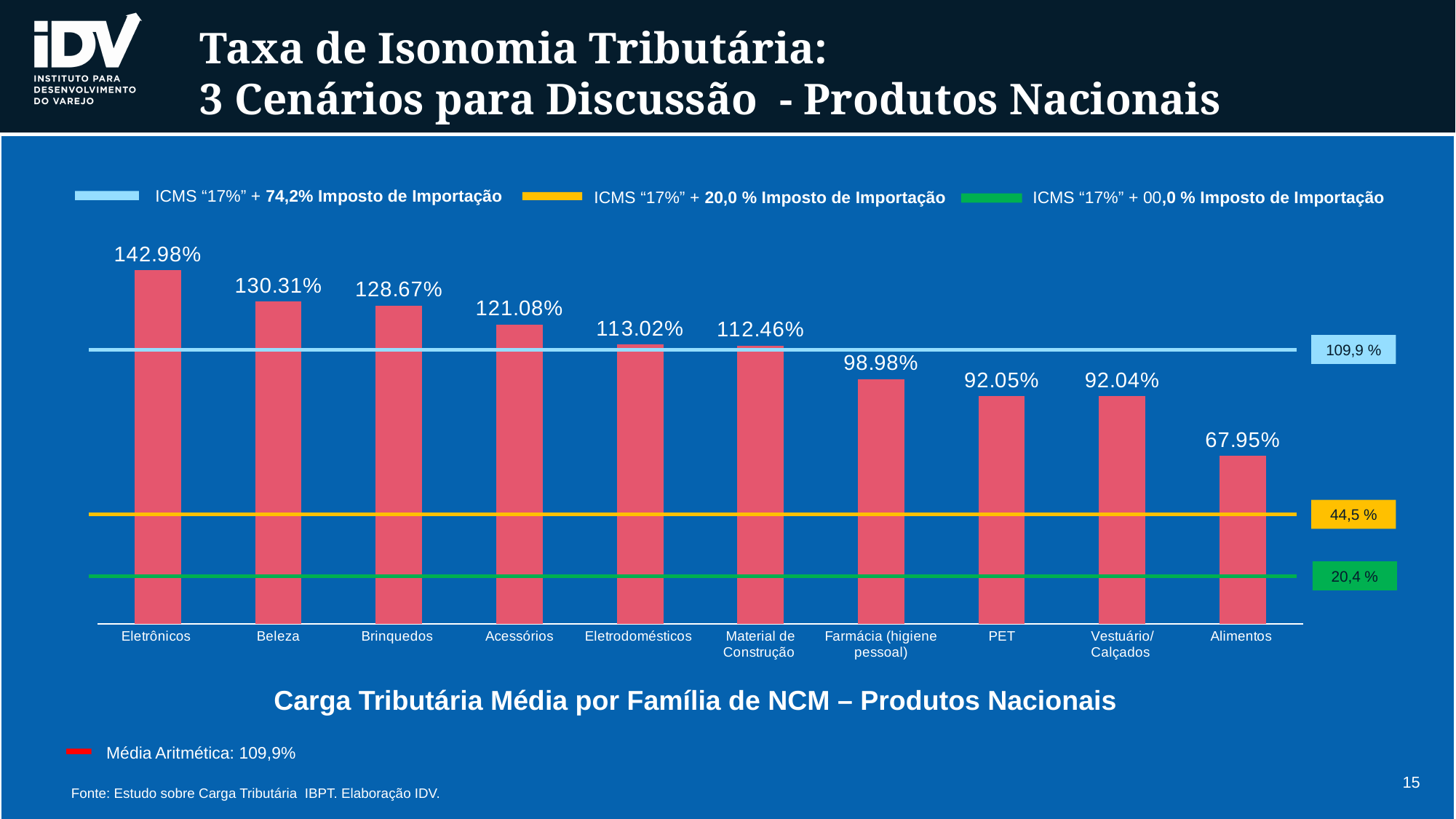
Which category has the lowest value? Alimentos What kind of chart is shown on the slide? Bar chart What value is labelled on the light blue horizontal reference line? 109,9 % What is the value shown for Eletrônicos? 142.98% What is the value shown for Alimentos? 67.95% Which has a larger value, Beleza or Brinquedos? Beleza Do the bar values rise or fall from left to right along the x axis? Fall What is the value shown for PET? 92.05% Which category has the highest value? Eletrônicos What is the difference between the values for Eletrônicos and Beleza? 12.67% What is the difference between the values for Brinquedos and Acessórios? 7.59% How many categories are shown on the x axis? 10